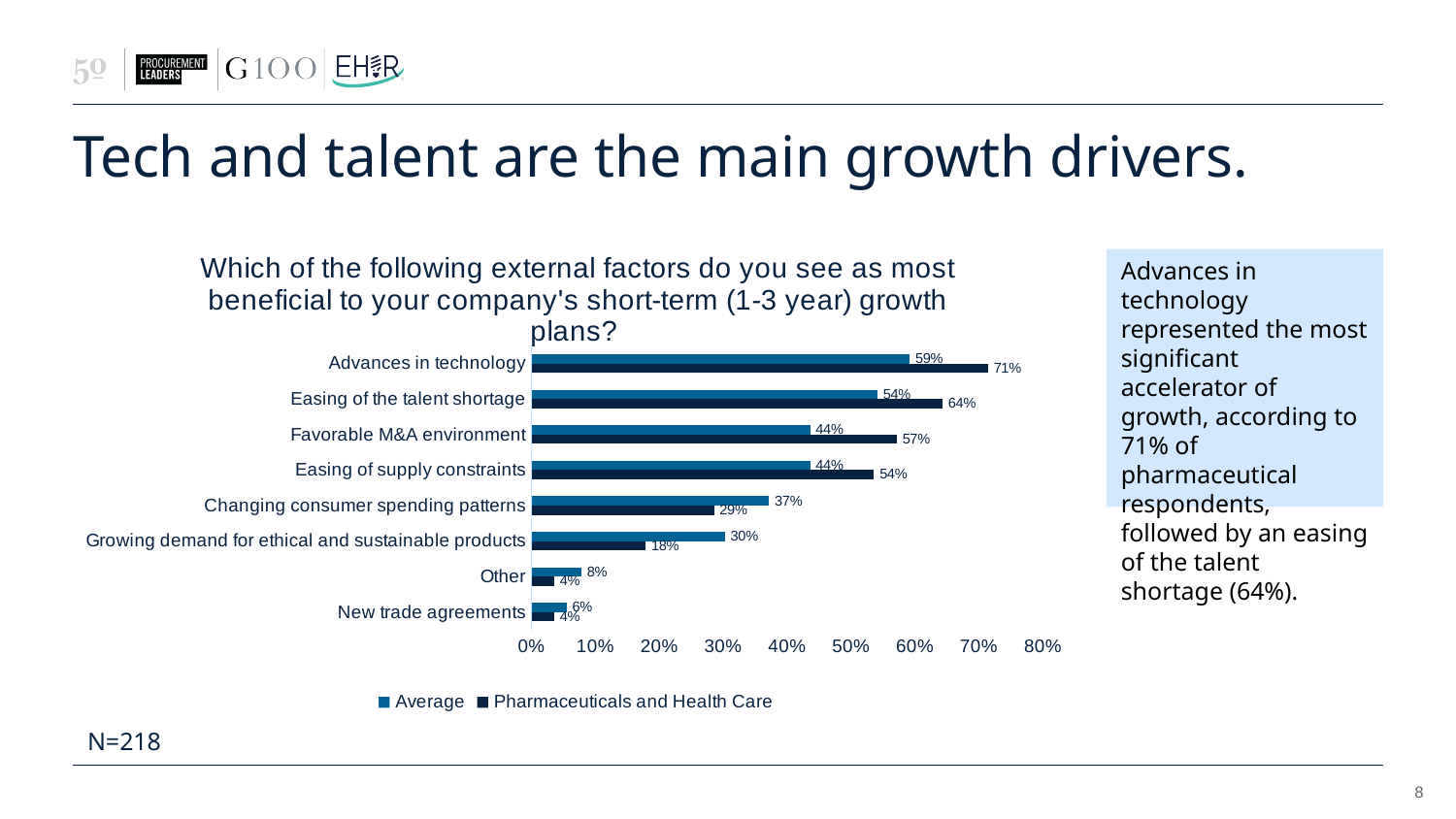
What is the Pharmaceuticals and Health Care value for Growing demand for ethical and sustainable products? 18% How many external factor categories are shown on the chart? 8 Which external factor has the highest Pharmaceuticals and Health Care value? Advances in technology What type of chart is shown on the slide? Bar chart For Changing consumer spending patterns, which series has the larger value, Average or Pharmaceuticals and Health Care? Average What is the Average value for Easing of the talent shortage? 54% Is the Pharmaceuticals and Health Care value for Favorable M&A environment greater or less than 50%? greater What percentage of Pharmaceuticals and Health Care respondents selected Advances in technology? 71% What is the difference between the Pharmaceuticals and Health Care value and the Average value for Advances in technology? 12% Which category has the lowest Average value? New trade agreements How many series does the legend list? 2 What is the sample size (N) stated on the slide? N=218